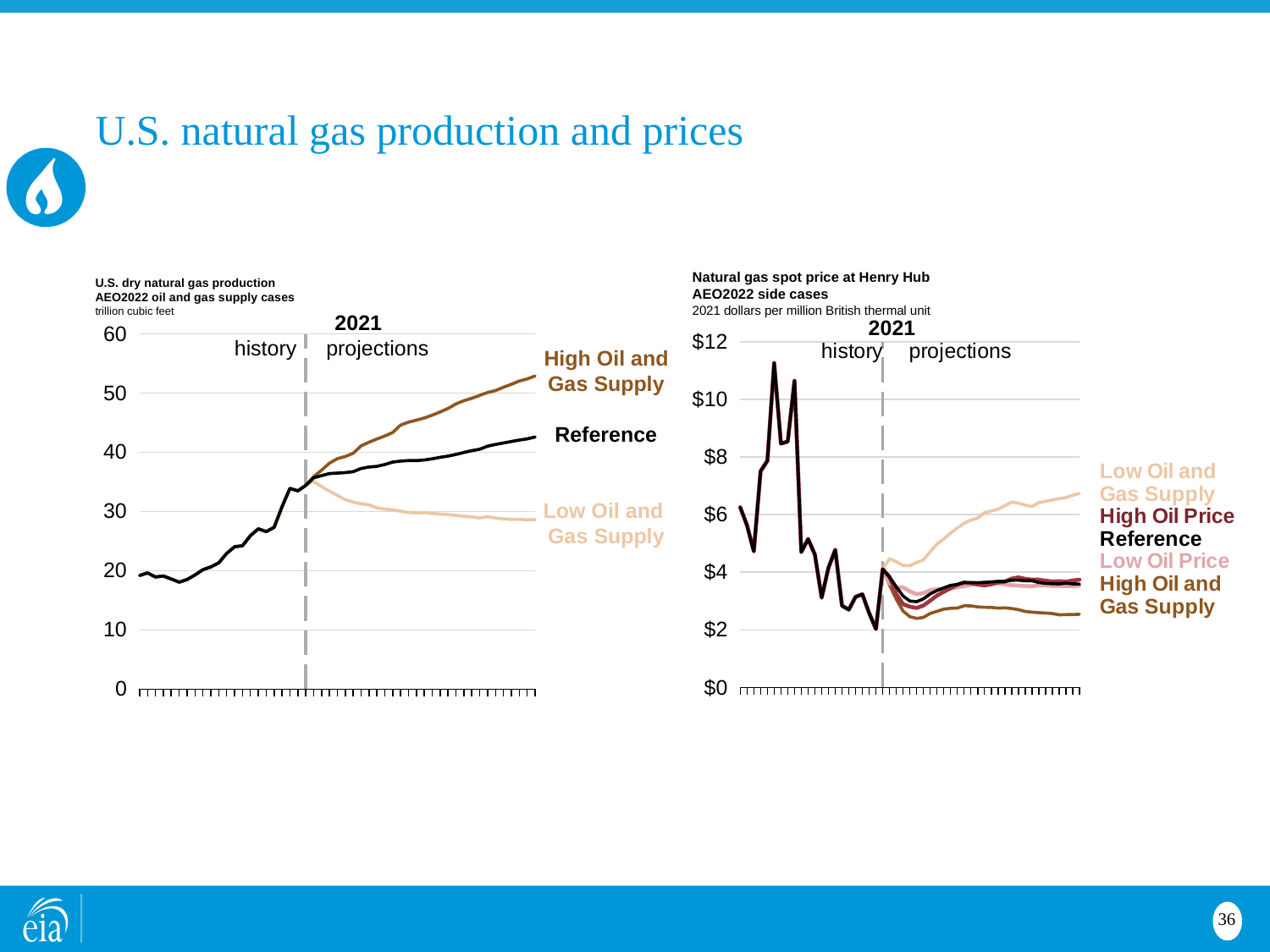
On the Natural gas spot price at Henry Hub chart, which series is highest at the end of the projection period? Low Oil and Gas Supply On the U.S. dry natural gas production chart, is the Low Oil and Gas Supply value at the end of the projections greater or less than 40? less On the U.S. dry natural gas production chart, is the High Oil and Gas Supply value at the end of the projections greater or less than 50? greater On the Natural gas spot price at Henry Hub chart, is the highest historical price peak greater or less than $10? greater On the U.S. dry natural gas production chart, which series is highest at the end of the projection period? High Oil and Gas Supply How many series are labelled on the U.S. dry natural gas production chart? 3 How many series are labelled on the Natural gas spot price at Henry Hub chart? 5 What kind of chart is the U.S. dry natural gas production chart on the left? line chart On the U.S. dry natural gas production chart, does the Low Oil and Gas Supply series rise or fall over the projection period? fall On the Natural gas spot price at Henry Hub chart, which series is lowest at the end of the projection period? High Oil and Gas Supply What unit is used on the y axis of the U.S. dry natural gas production chart? trillion cubic feet